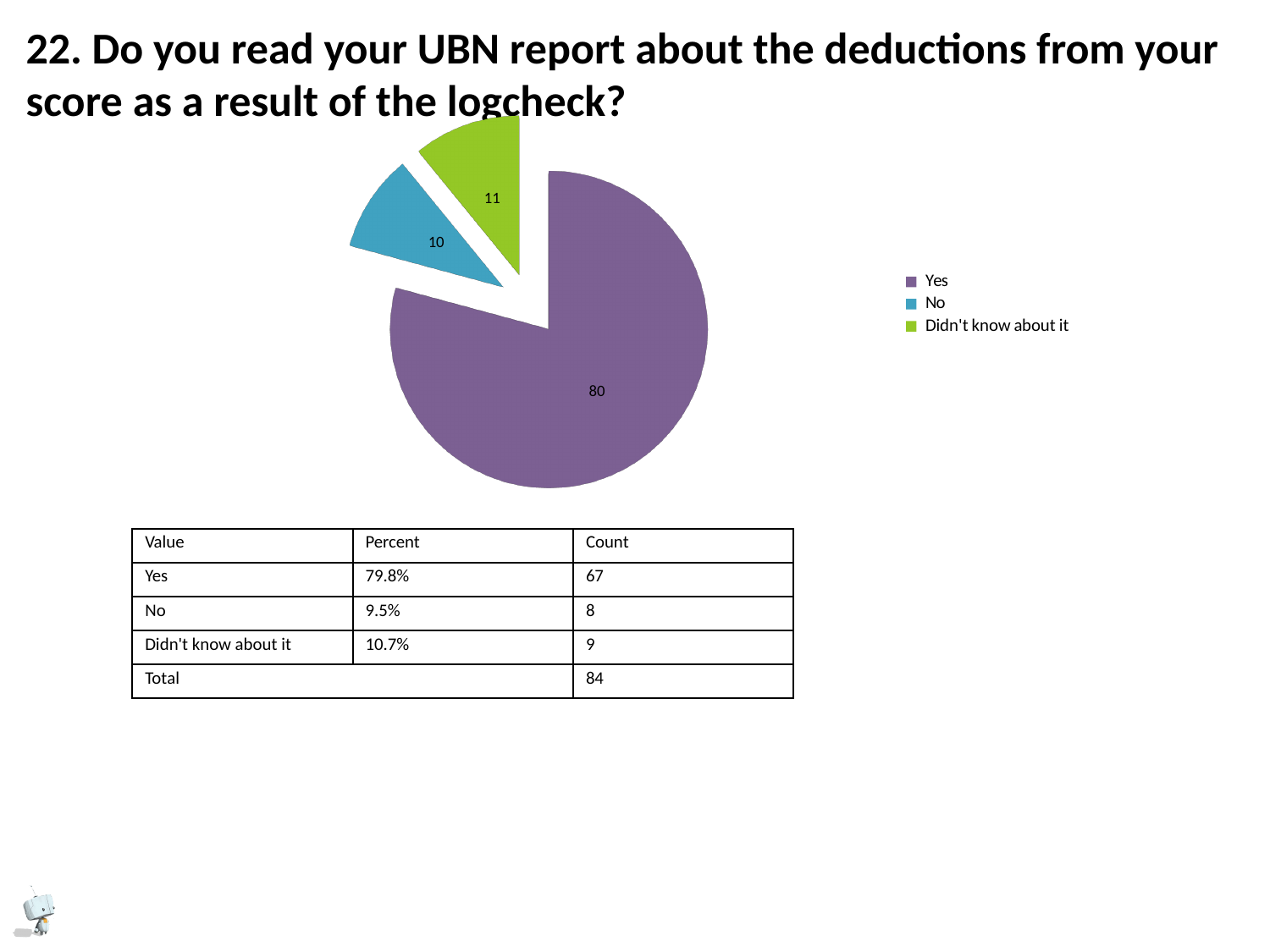
Which slice is larger in the pie chart, Yes or 'Didn't know about it'? Yes What is the data label shown on the Yes slice of the pie chart? 80 Which category has the largest slice in the pie chart? Yes Which category has the smallest slice in the pie chart? No How many slices does the pie chart have? 3 What is the difference between the data labels of the Yes slice and the No slice? 70 What colour is the Yes slice in the pie chart? purple What is the data label shown on the 'Didn't know about it' slice of the pie chart? 11 What colour is the 'Didn't know about it' slice in the pie chart? green What is the data label shown on the No slice of the pie chart? 10 What kind of chart is shown on the slide? pie chart How many entries does the legend of the pie chart list? 3